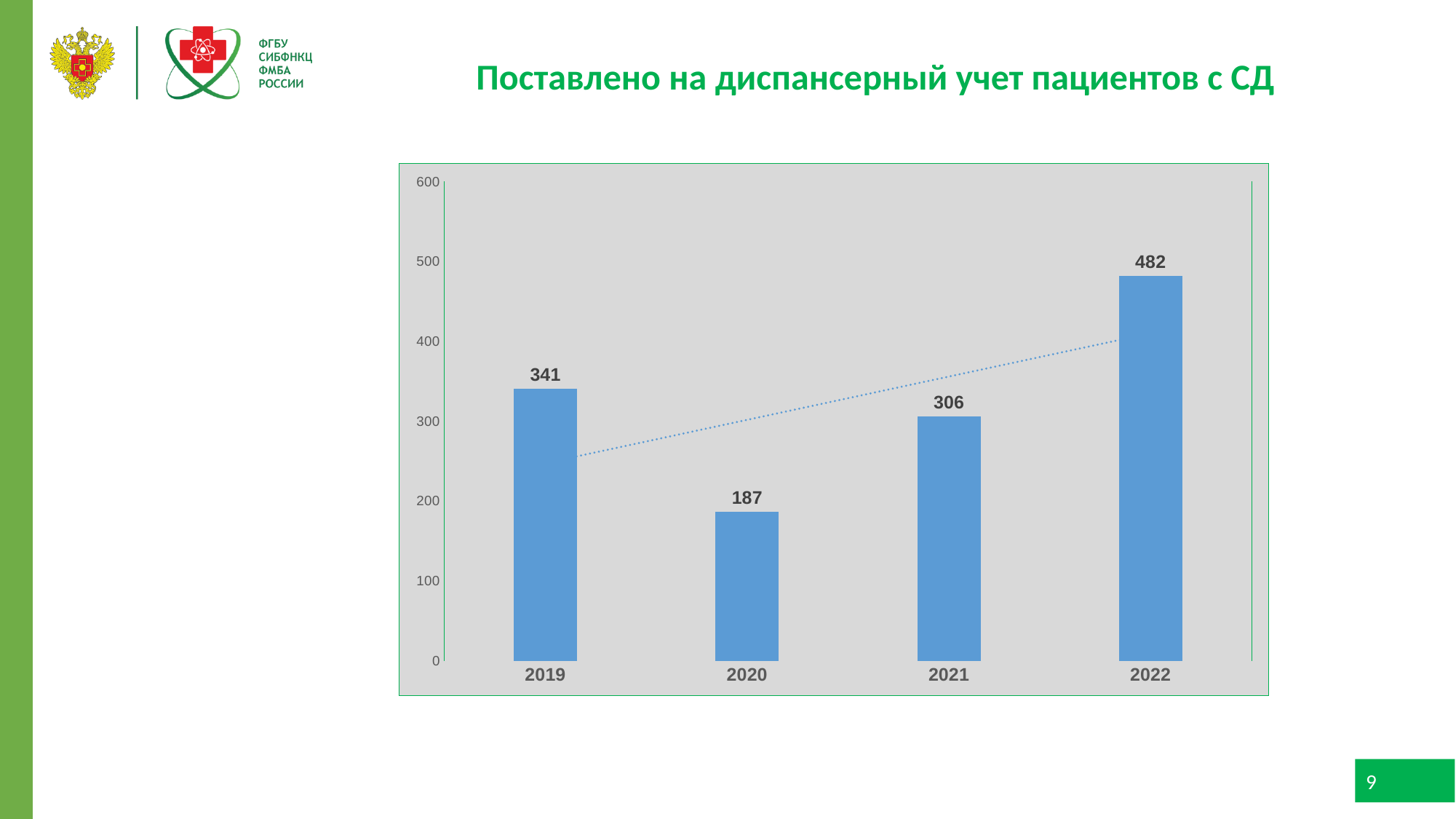
Is the value for 2022 greater or less than 400? greater Which year has the highest value? 2022 What is the value for 2021? 306 What is the value for 2019? 341 What is the value for 2020? 187 What is the value for 2022? 482 What is the difference between the values for 2021 and 2020? 119 How many years are shown on the x axis? 4 What kind of chart is shown on the slide? bar chart Which is larger, the value for 2019 or the value for 2021? 2019 Which year has the lowest value? 2020 What is the difference between the values for 2022 and 2019? 141